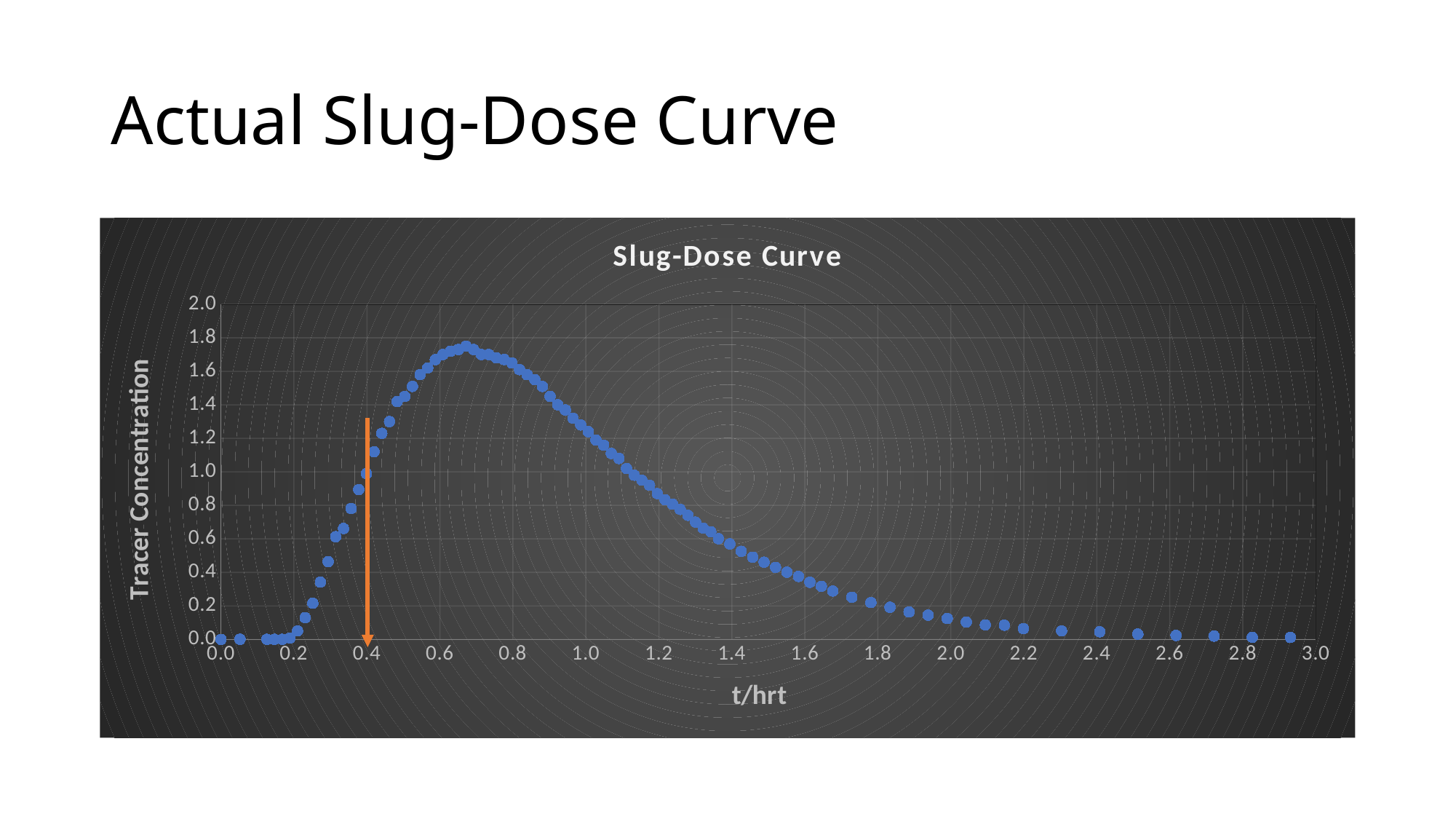
What is the title of the chart? Slug-Dose Curve Is the tracer concentration at t/hrt = 0.6 greater or less than 1.4? greater Do the tracer concentration values rise or fall as t/hrt increases from 0.2 to 0.6? rise Which is larger, the tracer concentration at t/hrt = 0.8 or at t/hrt = 1.6? t/hrt = 0.8 Is the tracer concentration at t/hrt = 1.4 greater or less than 0.8? less Is the tracer concentration at t/hrt = 1.0 greater or less than 1.0? greater What is the label of the vertical axis? Tracer Concentration What kind of chart is shown on the slide? Scatter chart Do the tracer concentration values rise or fall as t/hrt increases from 1.0 to 3.0? fall